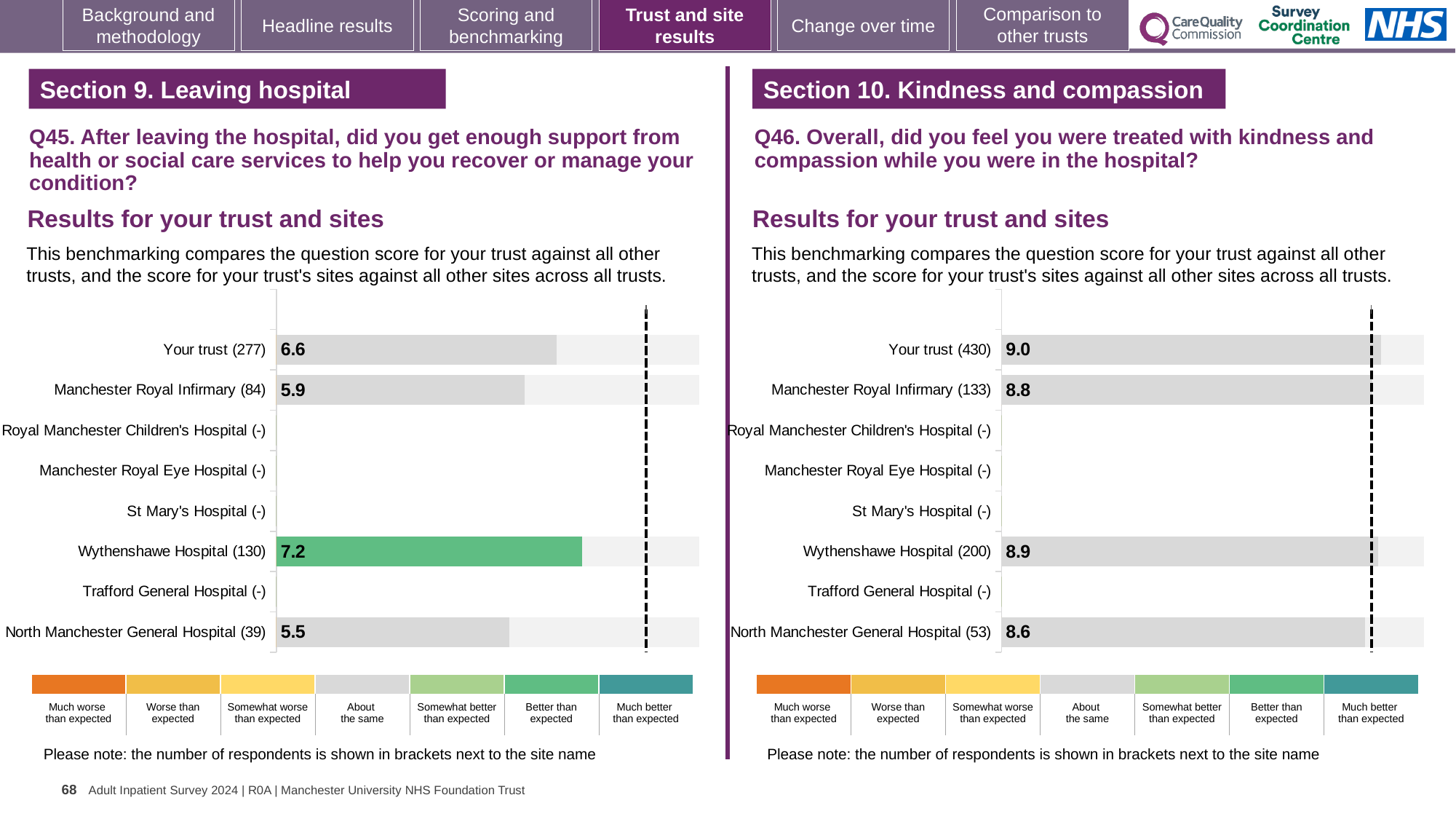
On the Q45 chart (left), what is the difference between the scores for Wythenshawe Hospital and North Manchester General Hospital? 1.7 On the Q45 chart (left), which site has the highest score? Wythenshawe Hospital On the Q46 chart (right), what is the score for Manchester Royal Infirmary? 8.8 On the Q45 chart (left), which site's bar is coloured green? Wythenshawe Hospital On the Q46 chart (right), which has the higher score, Your trust or Wythenshawe Hospital? Your trust On the Q45 chart (left), what is the score for Your trust? 6.6 On the Q45 chart (left), what is the score for Wythenshawe Hospital? 7.2 What kind of chart is used for the Q46 results (right)? Bar chart On the Q46 chart (right), what is the difference between the scores for Your trust and North Manchester General Hospital? 0.4 On the Q45 chart (left), which site has the lowest score? North Manchester General Hospital How many site/trust categories are listed on the Q45 chart (left)? 8 On the Q46 chart (right), what is the score for North Manchester General Hospital? 8.6